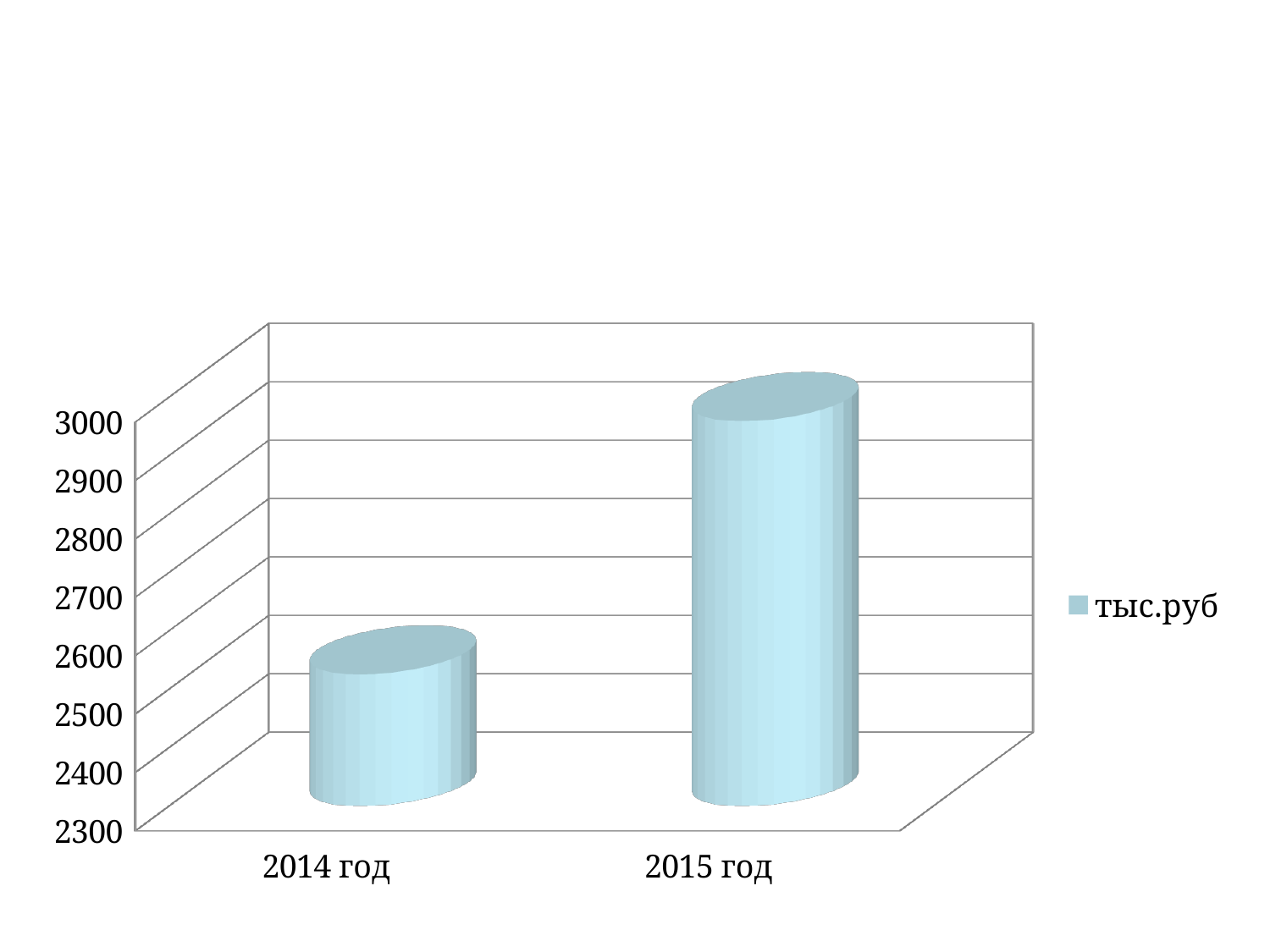
Which is larger, the value for 2014 год or the value for 2015 год? 2015 год Is the value for 2014 год greater or less than 2800? less Do the values rise or fall from 2014 год to 2015 год? rise What kind of chart is shown on the slide? bar chart What is the lowest value shown on the chart's vertical axis? 2300 How many series does the chart's legend list? 1 What is the name of the series shown in the chart's legend? тыс.руб Which category has the highest value in the chart? 2015 год Is the value for 2015 год greater or less than 2700? greater Which category has the lowest value in the chart? 2014 год How many categories are shown on the x axis of the chart? 2